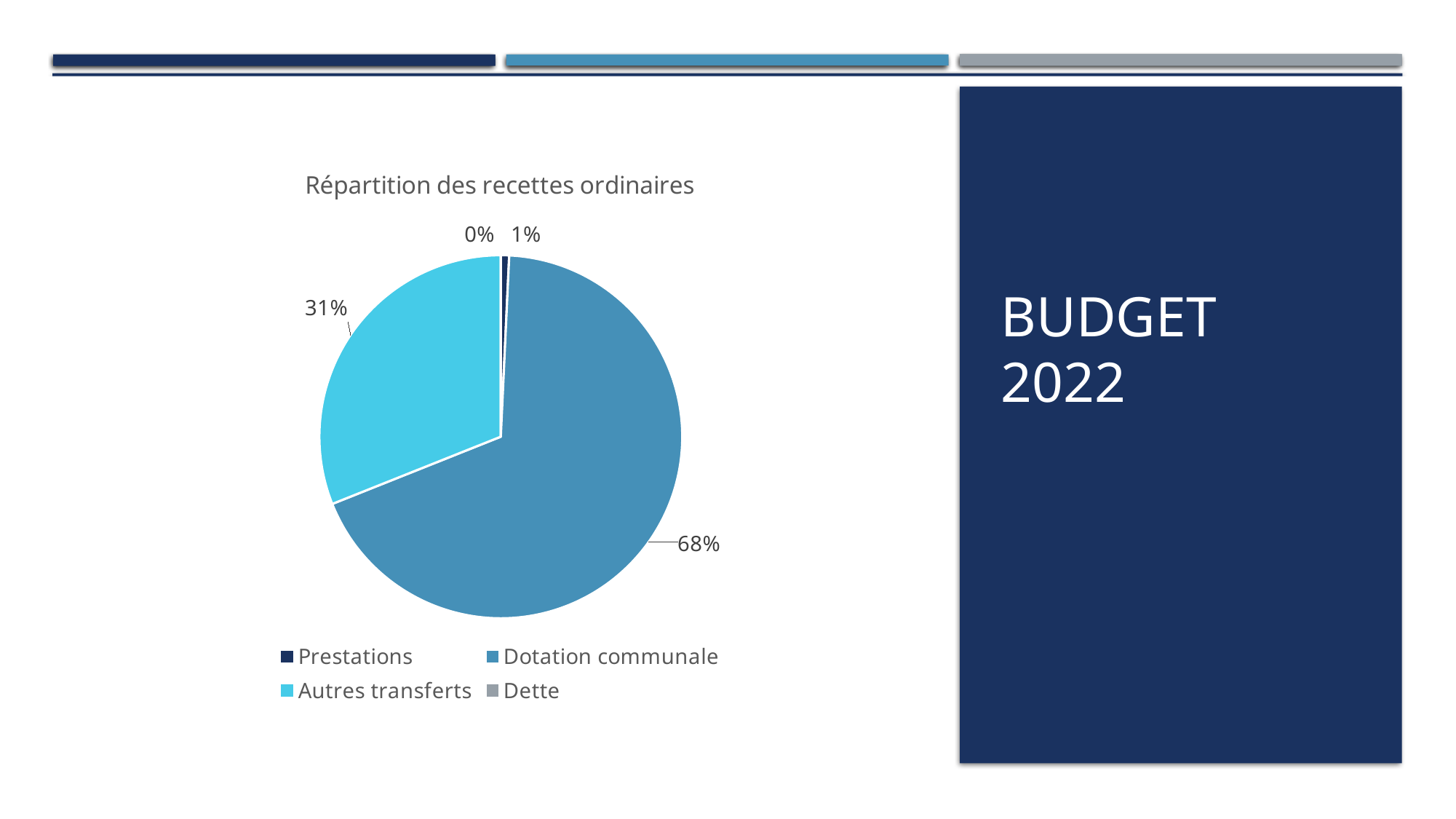
What is the difference in percentage points between Dotation communale and Autres transferts? 37 What type of chart is shown on the slide? pie chart What share of the pie does Dotation communale represent? 68% Which is larger, the share for Autres transferts or the share for Prestations? Autres transferts How many categories does the legend of the pie chart list? 4 What percentage is shown for Prestations? 1% Which category has the smallest share of the pie? Dette What share of the pie does Autres transferts represent? 31% What percentage is shown for Dette? 0% Which legend entry is shown in grey? Dette What is the title of the chart? Répartition des recettes ordinaires Which category has the largest share of the pie? Dotation communale